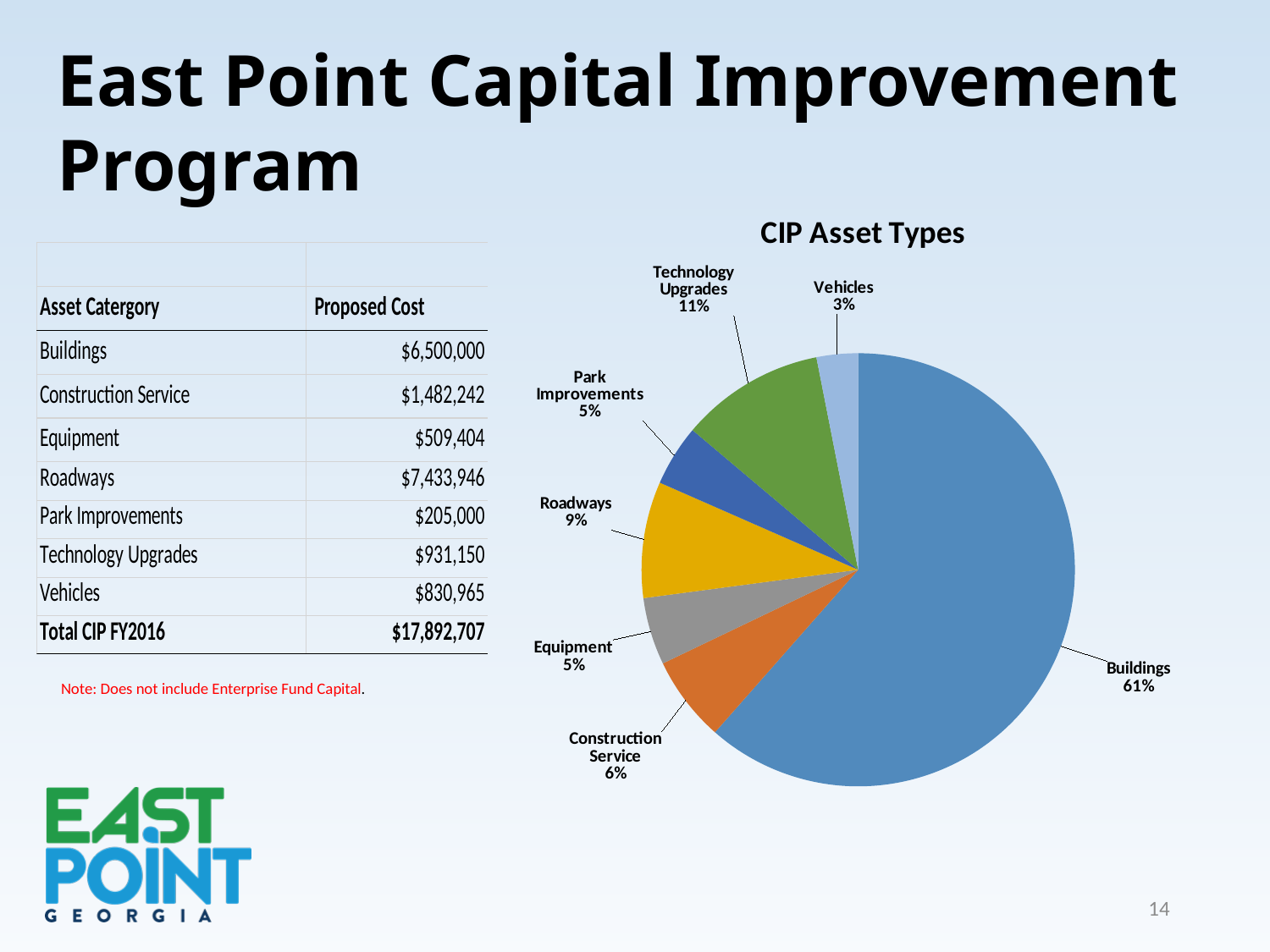
What is the difference in percentage points between Buildings and Technology Upgrades in the pie chart? 50 What percentage is shown for Vehicles in the pie chart? 3% What percentage is shown for Technology Upgrades in the pie chart? 11% What type of chart is shown on the slide? Pie chart What colour is the Buildings slice in the pie chart? Blue Which slice is larger in the pie chart, Roadways or Construction Service? Roadways Which category has the largest slice of the pie chart? Buildings What percentage is shown for Roadways in the pie chart? 9% What is the title of the chart? CIP Asset Types What share of the pie does Buildings represent? 61% How many slices does the pie chart have? 7 Which category has the smallest slice of the pie chart? Vehicles